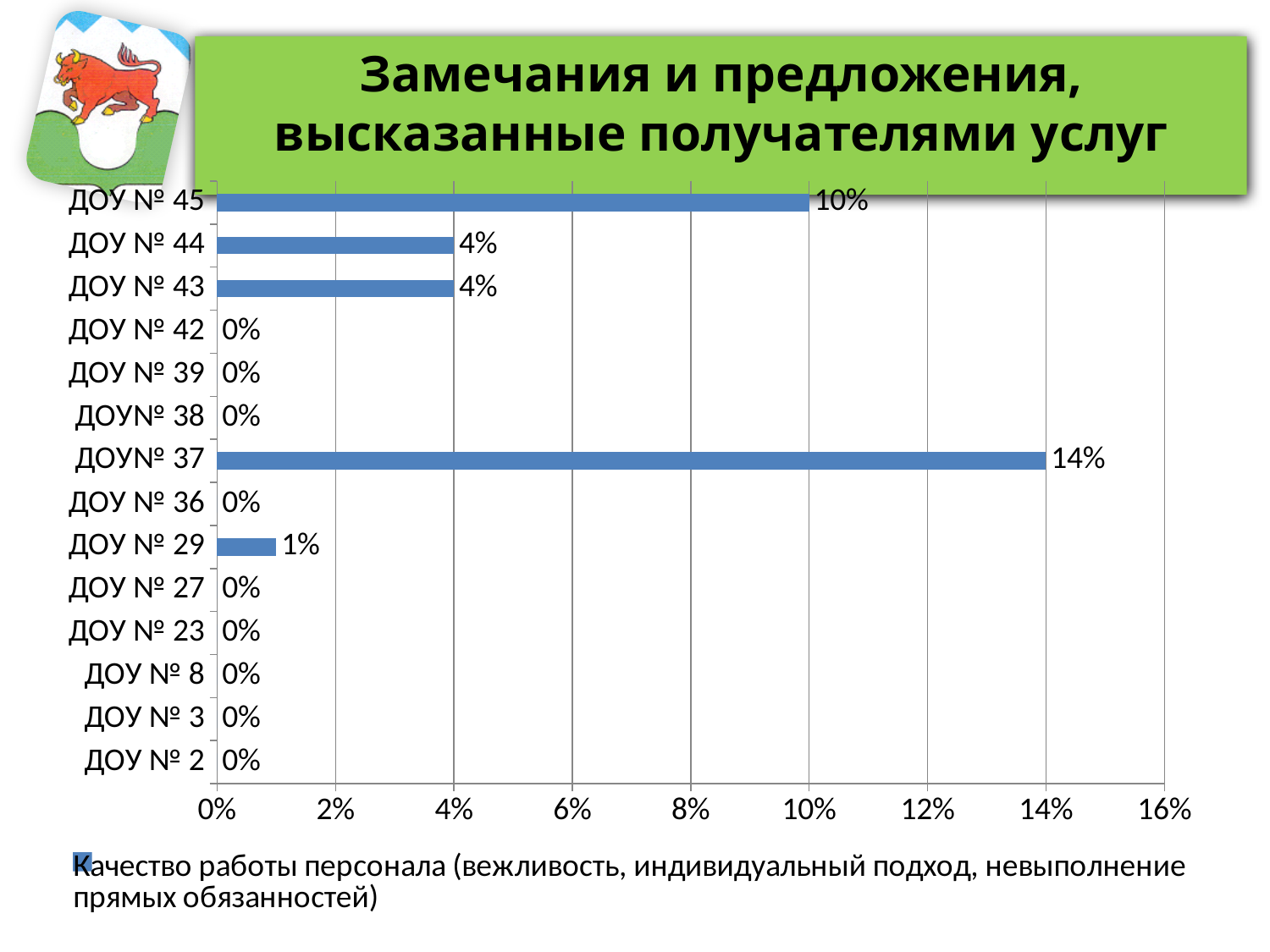
How many categories are shown on the chart? 14 Which is larger, the value for ДОУ № 45 or the value for ДОУ № 44? ДОУ № 45 Which category has the highest value? ДОУ№ 37 What is the difference between the values for ДОУ № 43 and ДОУ № 29? 3% What is the value for ДОУ№ 37? 14% What is the value for ДОУ № 44? 4% What is the value for ДОУ № 29? 1% What is the difference between the values for ДОУ№ 37 and ДОУ № 45? 4% Is the value for ДОУ№ 37 greater or less than 12%? greater How many series does the legend list? 1 What is the value for ДОУ № 45? 10% What kind of chart is shown on the slide? bar chart